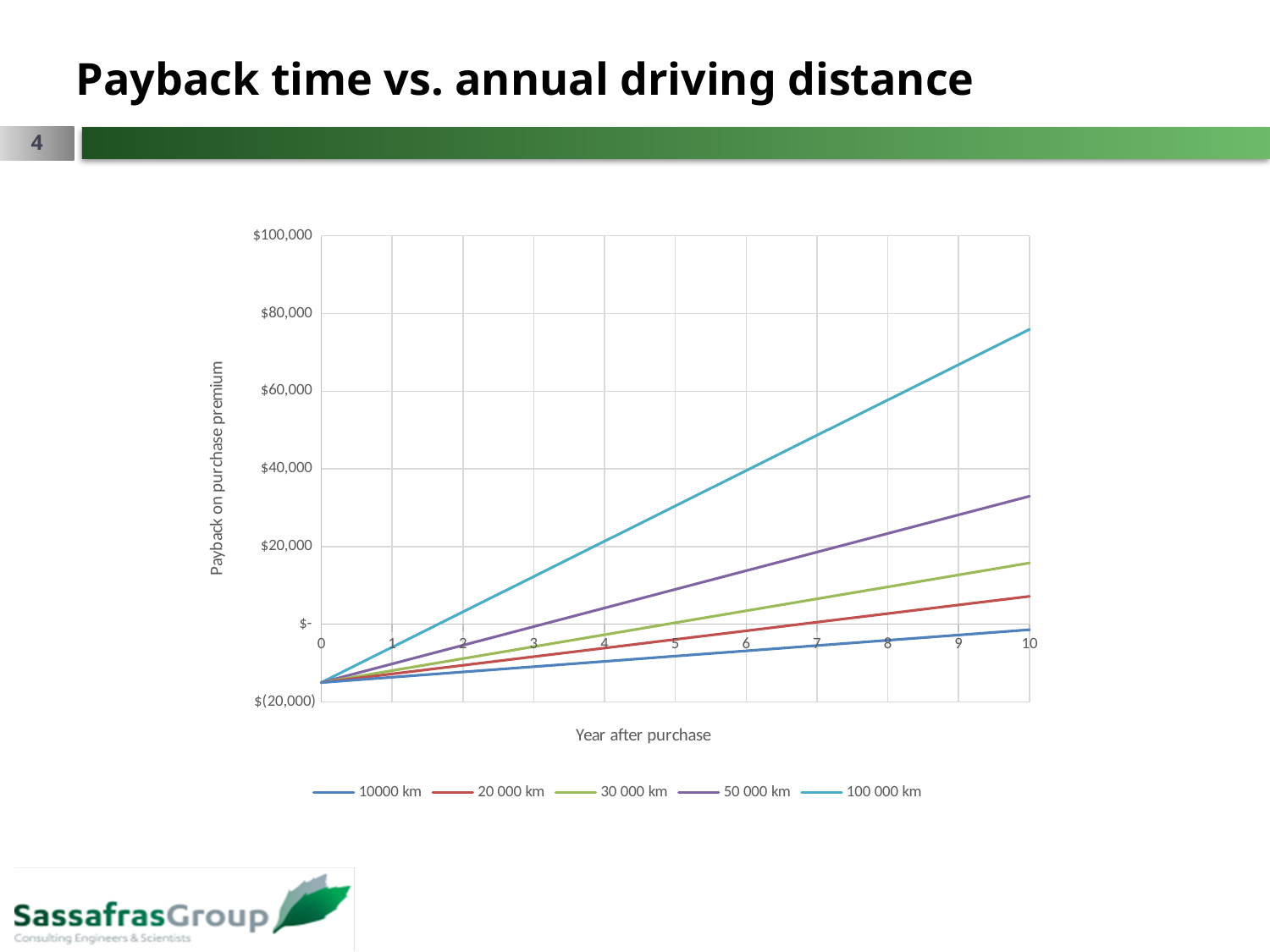
What kind of chart is shown on the slide? line chart How many series does the legend list? 5 Do the values of the 20 000 km series rise or fall as the year after purchase increases? rise Is the value for the 30 000 km series at year 10 greater or less than $20,000? less Is the value for the 10000 km series at year 5 greater or less than $0? less Which series has the lowest payback at year 10? 10000 km Is the value for the 100 000 km series at year 10 greater or less than $60,000? greater At year 10, which is larger: the 100 000 km series or the 50 000 km series? 100 000 km What is the title of the chart's vertical axis? Payback on purchase premium What is the title of the chart's horizontal axis? Year after purchase Which series has the highest payback at year 10? 100 000 km